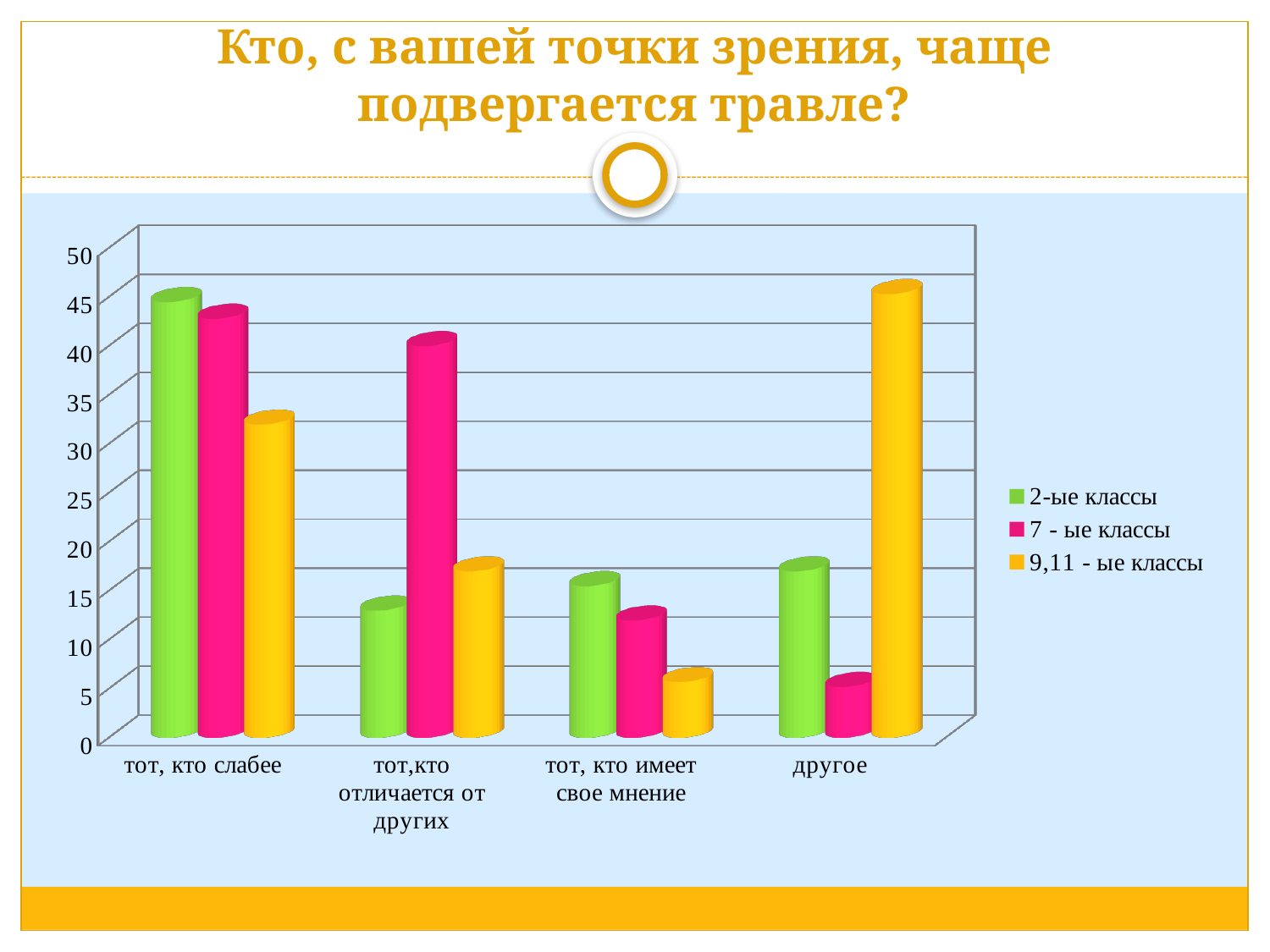
Is the value for "7 - ые классы" in the category "тот,кто отличается от других" greater or less than 35? greater Is the value for "9,11 - ые классы" in the category "тот, кто имеет свое мнение" greater or less than 10? less Which category has the highest value for the series "9,11 - ые классы"? другое Which category has the highest value for the series "7 - ые классы"? тот, кто слабее Which category has the lowest value for the series "9,11 - ые классы"? тот, кто имеет свое мнение What kind of chart is shown on the slide? bar chart What is the title of the chart on the slide? Кто, с вашей точки зрения, чаще подвергается травле? How many series does the chart's legend list? 3 In the category "тот,кто отличается от других", which series has the larger value: "2-ые классы" or "7 - ые классы"? 7 - ые классы How many categories are shown on the x axis of the chart? 4 Which category has the lowest value for the series "7 - ые классы"? другое Is the value for "2-ые классы" in the category "тот, кто слабее" greater or less than 40? greater